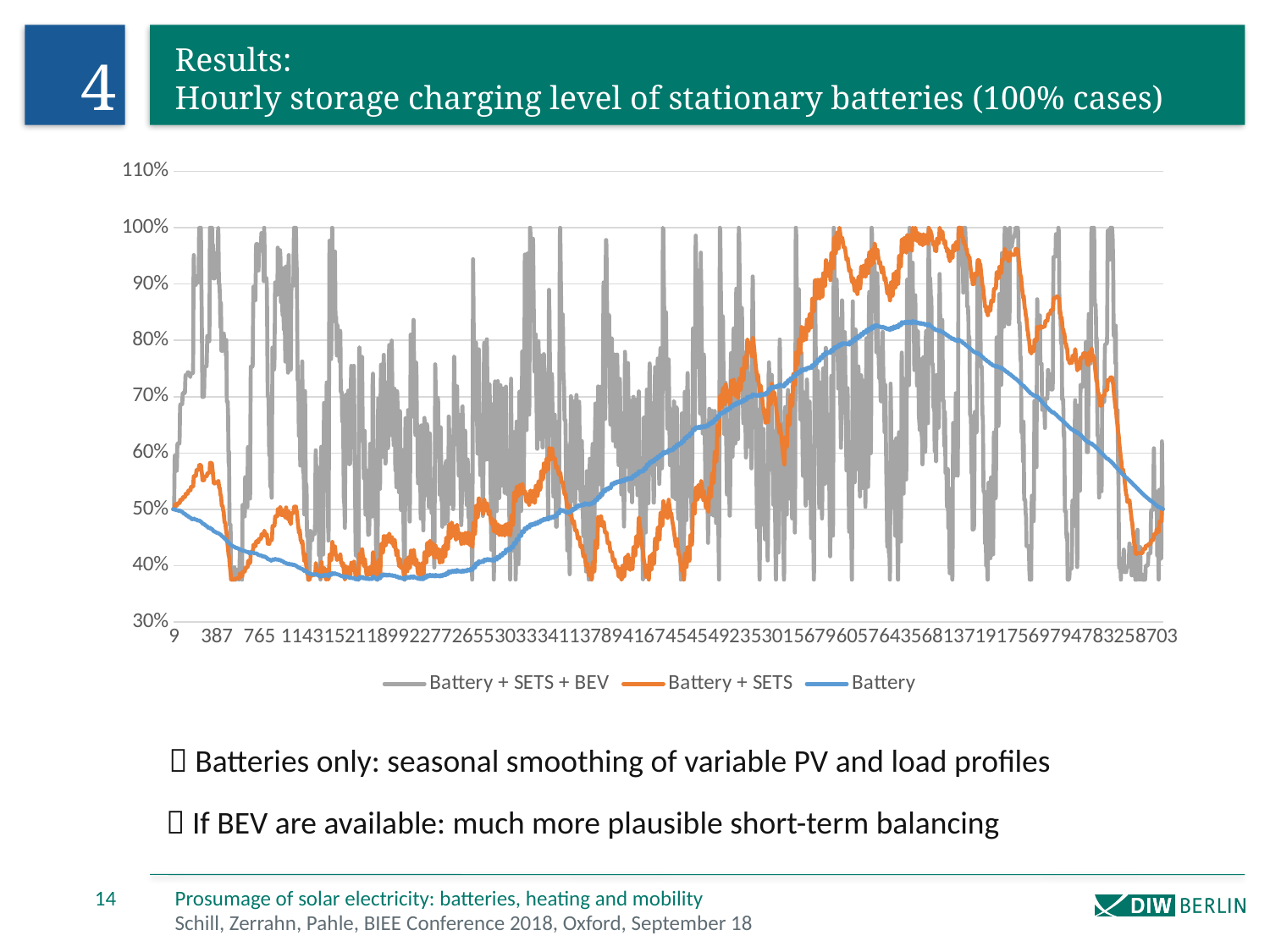
Is the highest value of the Battery series greater or less than 70%? greater Is the highest value of the Battery + SETS series greater or less than 90%? greater Does the Battery series rise or fall between the x-axis labels 3341 and 5301? rise How many series does the legend list? 3 What kind of chart is shown on the slide? line chart Does the Battery series rise or fall between the x-axis labels 7569 and 8703? fall What is the highest value shown on the y axis? 110% Is the lowest value of the Battery series greater or less than 40%? less Which series reaches the lowest peak value over the year? Battery Which series is drawn in blue? Battery Which series is drawn in grey? Battery + SETS + BEV